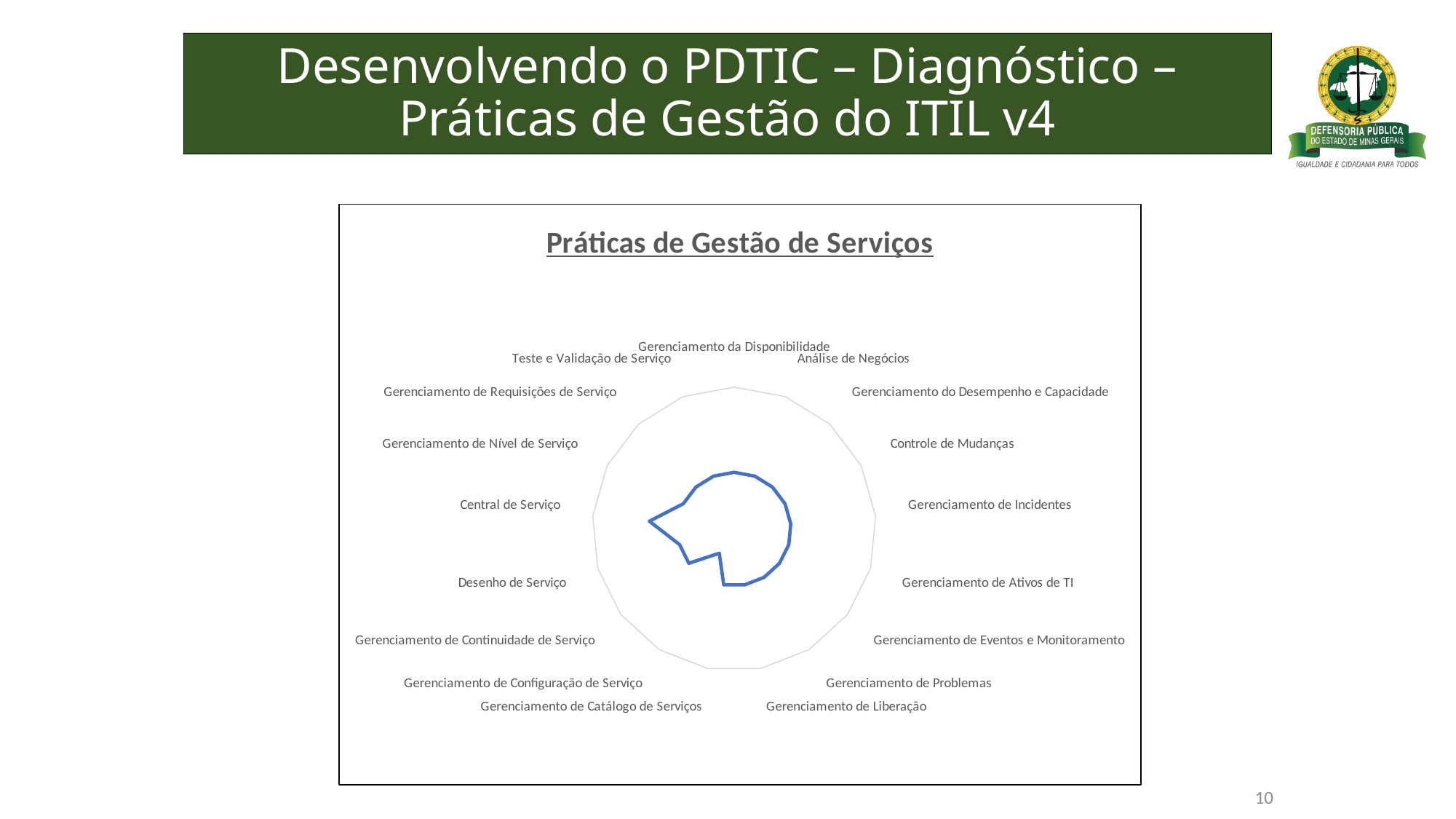
Which category has the highest value on the radar chart? Central de Serviço What kind of chart is shown on the slide? Radar chart What is the title of the chart? Práticas de Gestão de Serviços Which category is plotted at the top of the radar chart? Gerenciamento da Disponibilidade How many categories (practices) are plotted around the radar chart? 17